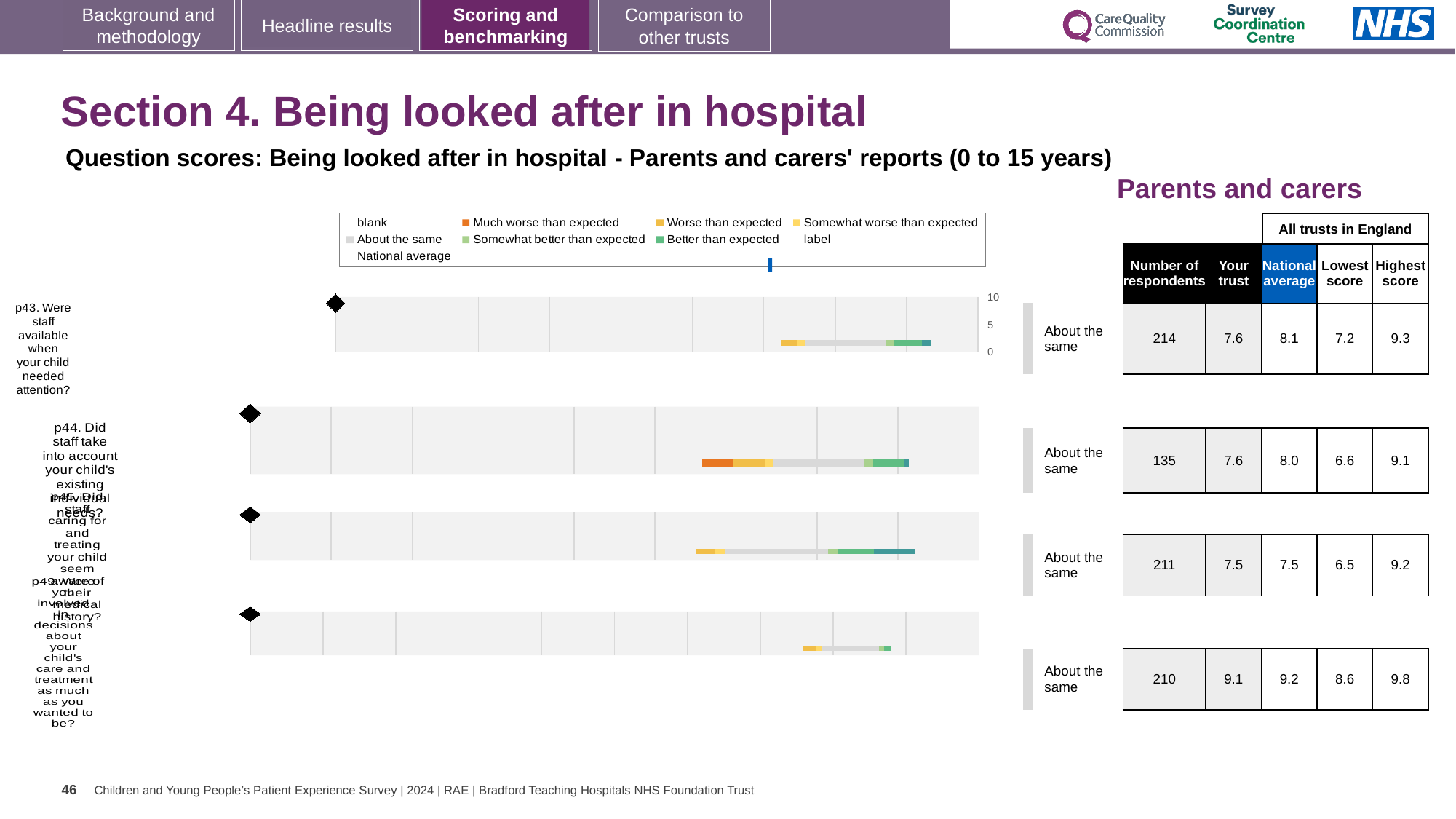
In the chart legend, which colour represents 'Much worse than expected'? orange For p44 (Did staff take into account your child's existing individual needs?), what is the national average score? 8.0 Which question has the highest 'Your trust' score? p49 For p43, what is the difference between the highest score and the lowest score among all trusts in England? 2.1 In the chart legend, what does the blue marker represent? National average For p44, which is larger: the 'Your trust' score or the national average? National average How many questions (bar charts) are shown on the slide? 4 For p43 (Were staff available when your child needed attention?), what is the 'Your trust' score? 7.6 What kind of chart is used to show the question scores on this slide? bar chart For p49 (Were you involved in decisions about your child's care and treatment as much as you wanted to be?), what is the highest score among all trusts in England? 9.8 For p43, how many respondents are there? 214 What benchmark category is shown for p45 (Did staff caring for and treating your child seem aware of their medical history?)? About the same